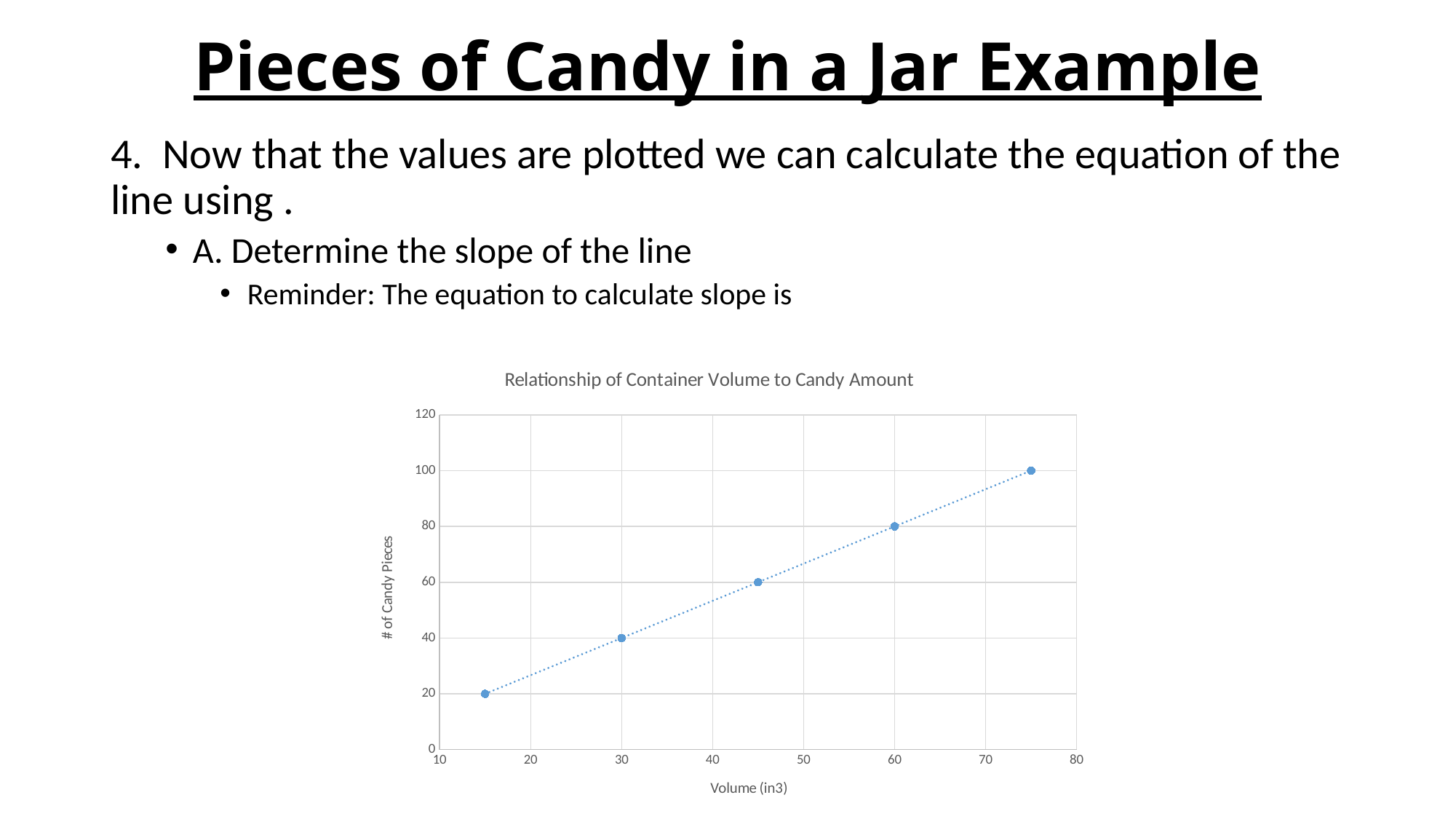
What is the number of candy pieces for the rightmost plotted point? 100 Is the number of candy pieces for the middle plotted point greater or less than 40? greater What is the title of the chart? Relationship of Container Volume to Candy Amount What is the difference in candy pieces between the volume of 60 in3 and the volume of 30 in3? 40 Do the values rise or fall as volume increases along the x axis? rise How many data points are plotted on the chart? 5 Which has more candy pieces: the point at 30 in3 or the point at 60 in3? 60 in3 What is the number of candy pieces at a volume of 30 in3? 40 What is the label of the y axis? # of Candy Pieces What type of chart is shown on the slide? scatter chart What is the number of candy pieces for the leftmost plotted point? 20 What is the number of candy pieces at a volume of 60 in3? 80